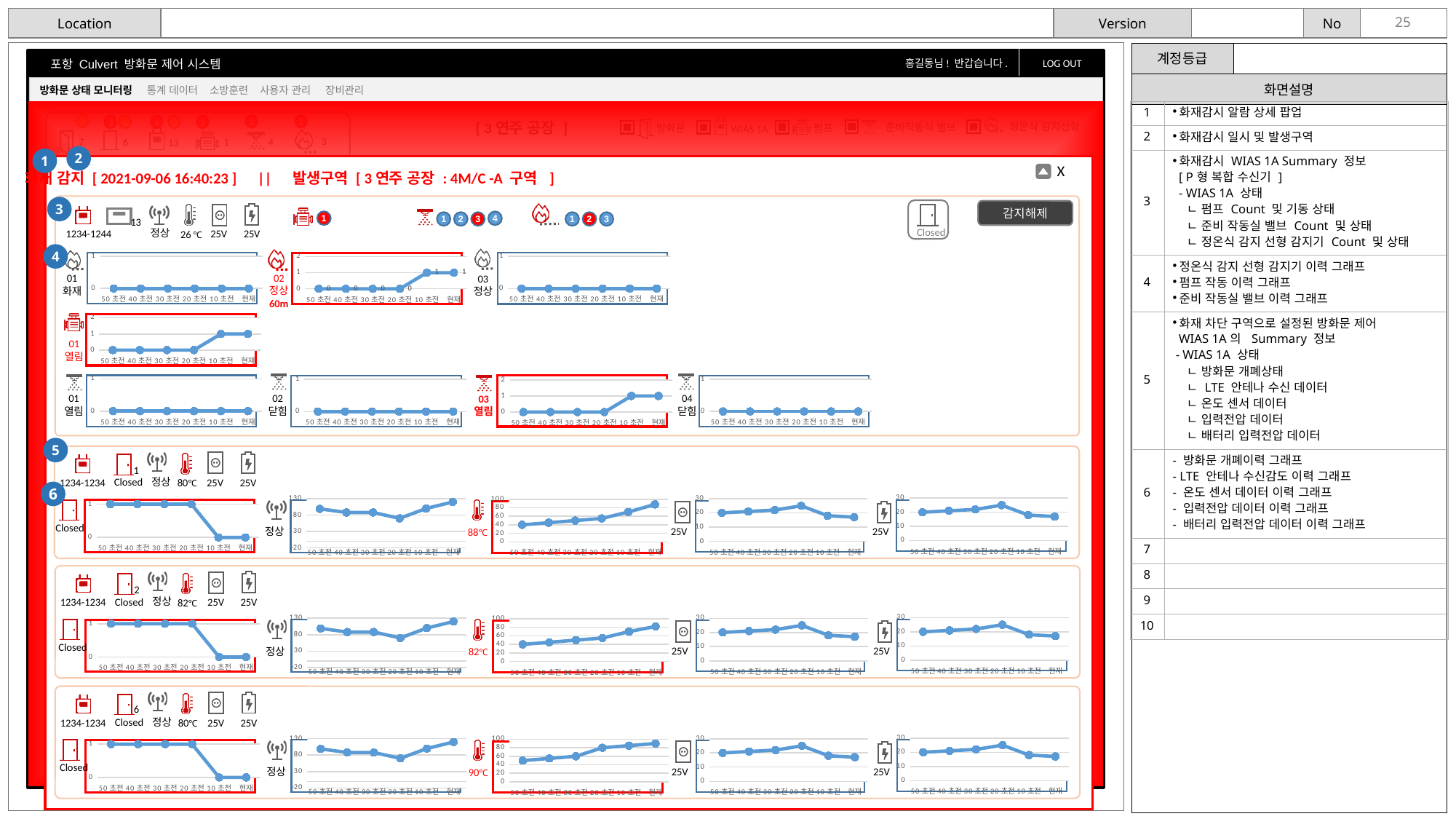
What kind of chart is used for the history graphs in the fire detection popup? line chart How many time points are plotted along the x axis of each history graph (from 50 초전 to 현재)? 6 In the first door row (door 1, 80℃), is the value at 현재 on the first 25V voltage graph greater or less than 30? less In the top section, does the 02 정상 detector graph rise or fall from 50 초전 to 현재? rise In the first door row (door 1, 80℃), is the value at 50 초전 on the temperature graph (88℃) greater or less than 60? less In the top section, what is the data label at 50 초전 on the 02 정상 detector graph (the one outlined in red)? 0 In the first door row (door 1, 80℃), does the temperature graph (88℃) rise or fall from 50 초전 to 현재? rise What is the label of the last point on the x axis of the history graphs? 현재 In the first door row (door 1, 80℃), does the Closed door-state graph rise or fall from 50 초전 to 현재? fall In the first door row (door 1, 80℃), is the value at 현재 on the LTE antenna graph (정상) greater or less than 80? greater What is the label of the first point on the x axis of the history graphs? 50 초전 In the top section, what is the data label at 현재 on the 02 정상 detector graph (the one outlined in red)? 1